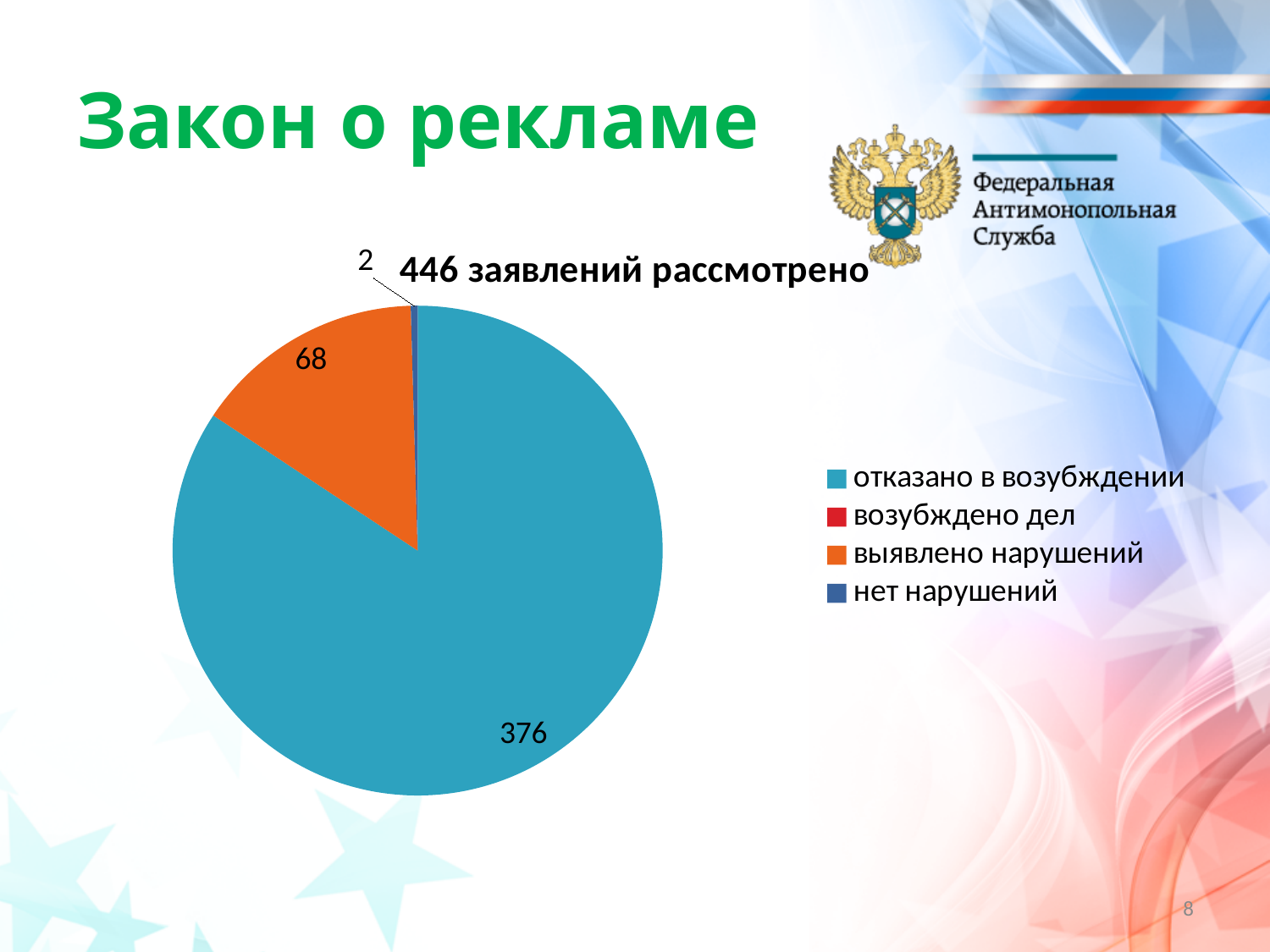
What is the title of the chart? 446 заявлений рассмотрено What type of chart is shown on the slide? pie chart What is the sum of the three labelled slice values (376, 68 and 2)? 446 What value is shown for the slice 'нет нарушений'? 2 Which category has the largest slice of the pie? отказано в возубждении How many entries does the chart legend list? 4 What value is shown for the slice 'выявлено нарушений'? 68 Which is larger: 'выявлено нарушений' or 'нет нарушений'? выявлено нарушений What is the difference between the values for 'отказано в возубждении' and 'выявлено нарушений'? 308 Of the slices with printed data labels, which has the smallest value? нет нарушений What value is shown for the slice 'отказано в возубждении'? 376 What is the difference between the values for 'выявлено нарушений' and 'нет нарушений'? 66